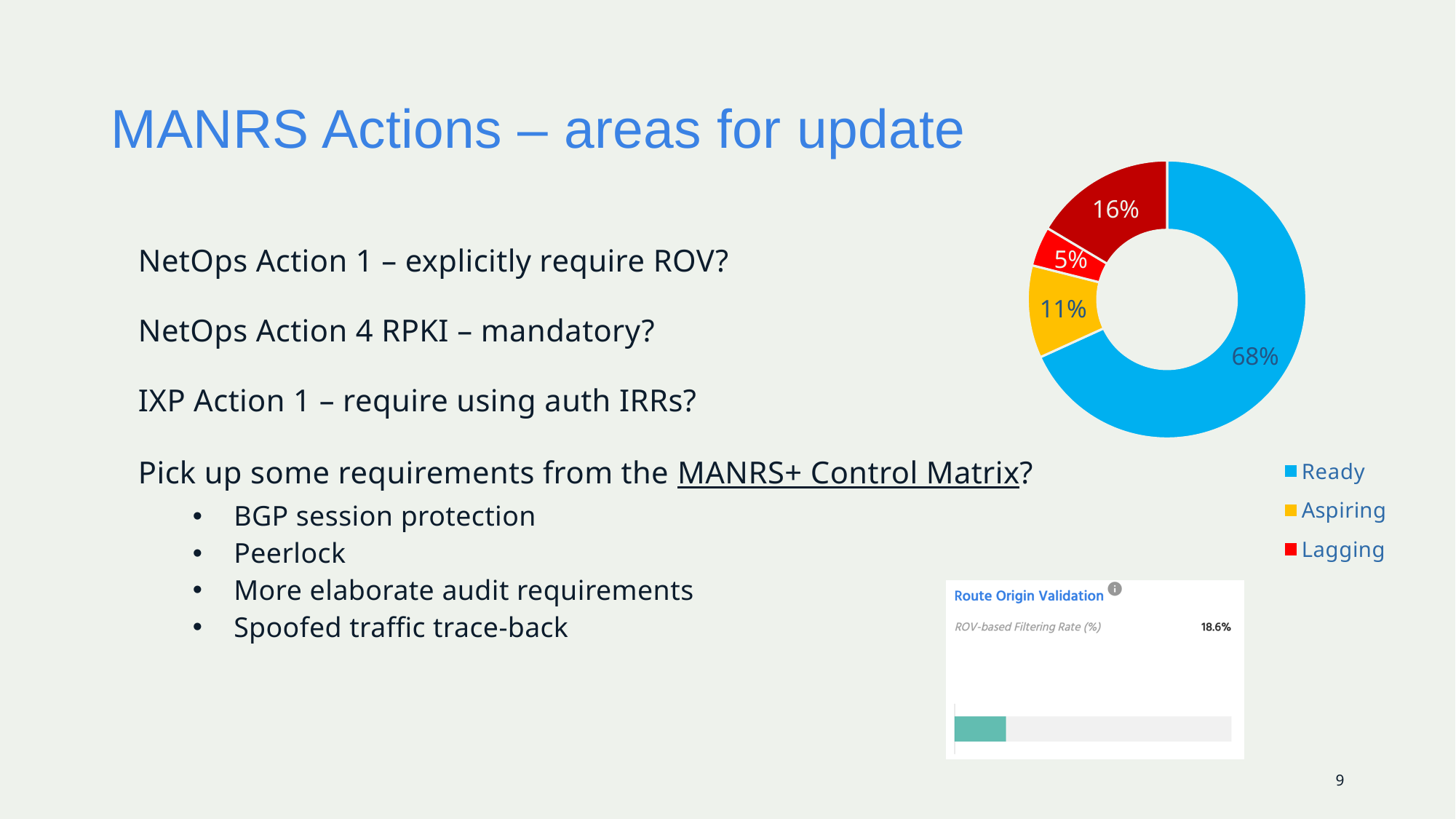
In the Route Origin Validation panel at the bottom right, what is the ROV-based Filtering Rate (%)? 18.6% In the doughnut chart, which legend category has the smallest slice? Lagging In the doughnut chart, which legend category has the largest slice? Ready In the doughnut chart, what is the difference in percentage points between Ready and Aspiring? 57 percentage points What kind of chart is shown in the top right of the slide? doughnut (pie) chart In the doughnut chart, what percentage is shown for Lagging? 5% In the doughnut chart, what percentage is shown for Aspiring? 11% How many entries does the legend of the doughnut chart list? 3 How many slices does the doughnut chart have? 4 In the doughnut chart, what percentage is shown for Ready? 68% In the doughnut chart, which is larger: Aspiring or Lagging? Aspiring In the doughnut chart, what colour is the Ready slice? blue